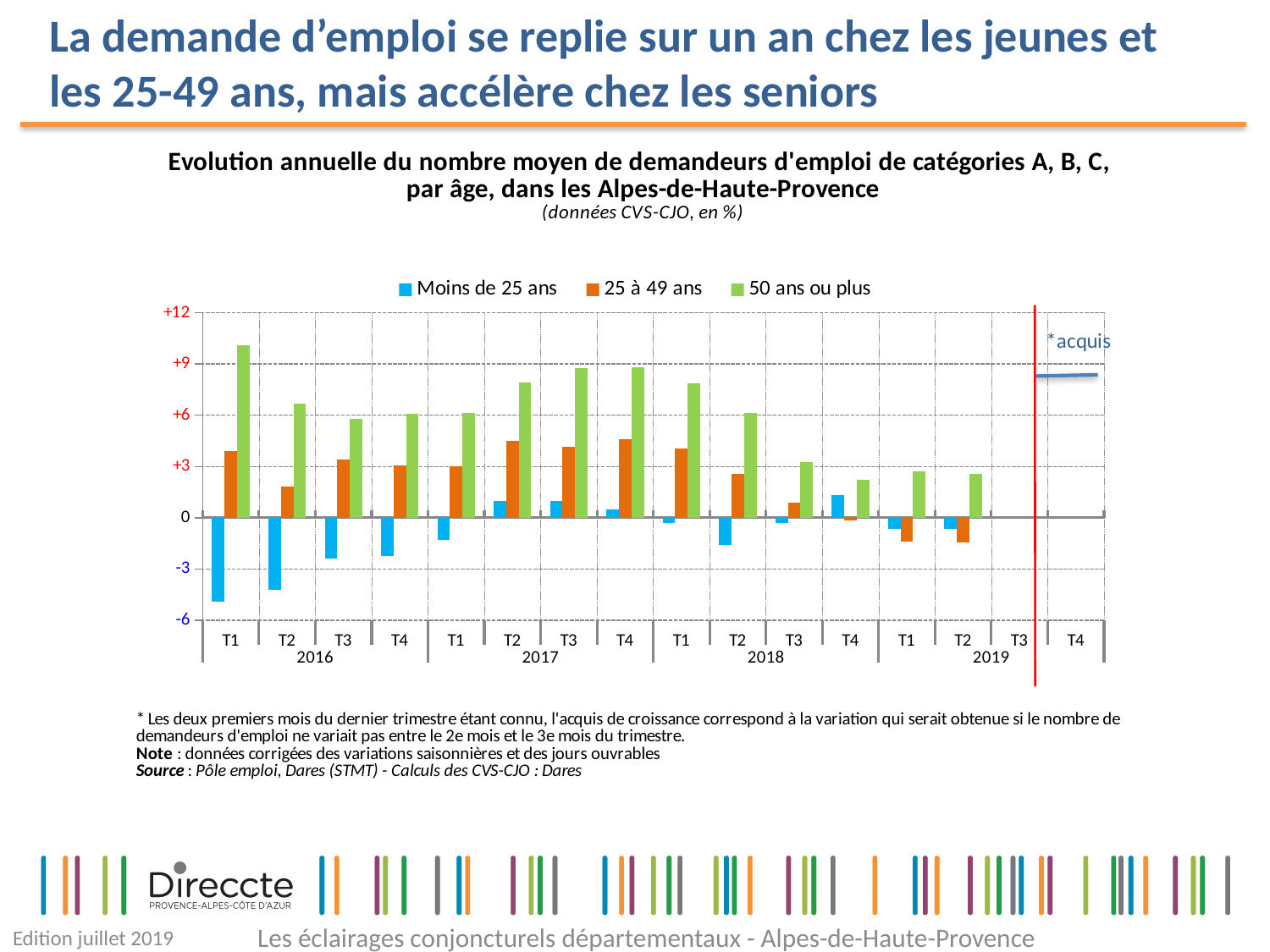
In which quarter does the '50 ans ou plus' series reach its highest value? T1 2016 Is the value for '50 ans ou plus' in T1 2016 greater or less than +9? greater Is the value for 'Moins de 25 ans' in T1 2016 greater or less than -3? less How many series does the legend list? 3 What kind of chart is shown on the slide? bar chart Which age groups are listed in the legend? Moins de 25 ans, 25 à 49 ans, 50 ans ou plus Is the value for '25 à 49 ans' in T2 2017 greater or less than +3? greater In T1 2016, which series has the larger value: '25 à 49 ans' or '50 ans ou plus'? 50 ans ou plus Does the '50 ans ou plus' series rise or fall from T4 2017 to T2 2019? fall In T4 2018, which series has the larger value: 'Moins de 25 ans' or '25 à 49 ans'? Moins de 25 ans In which quarter does the 'Moins de 25 ans' series reach its lowest value? T1 2016